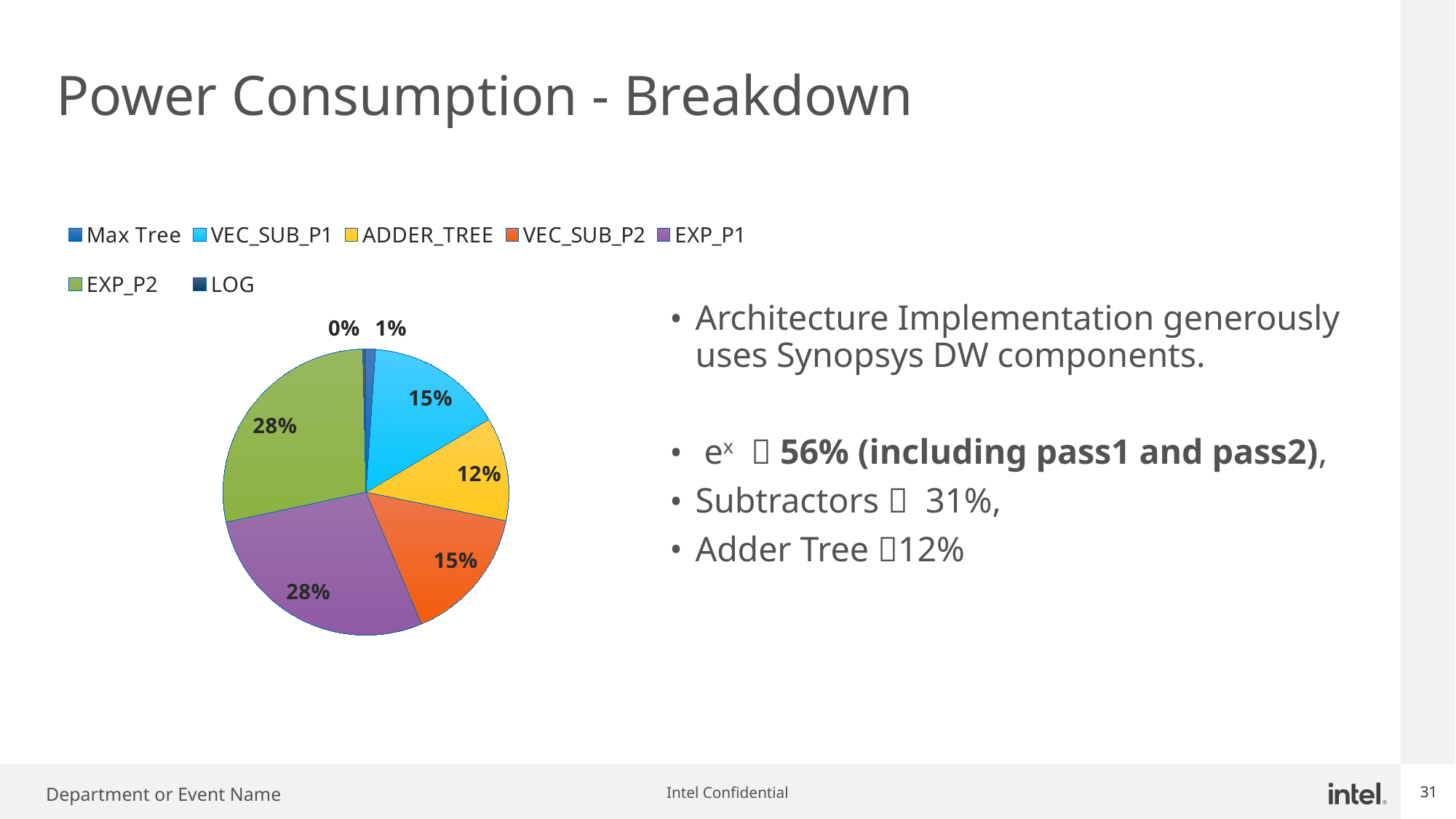
How many categories does the pie chart have? 7 What share of power consumption does ADDER_TREE account for? 12% What share of power consumption does Max Tree account for? 1% What share of power consumption does VEC_SUB_P1 account for? 15% What share of power consumption does EXP_P1 account for? 28% What is the difference in percentage points between the EXP_P2 share and the VEC_SUB_P2 share? 13 percentage points What type of chart is shown on the slide? Pie chart What share of power consumption does VEC_SUB_P2 account for? 15% Which category has the smallest share of the pie? LOG Which is larger, the share for VEC_SUB_P1 or the share for ADDER_TREE? VEC_SUB_P1 What share of power consumption does LOG account for? 0% What colour is the EXP_P2 slice in the pie chart? Green